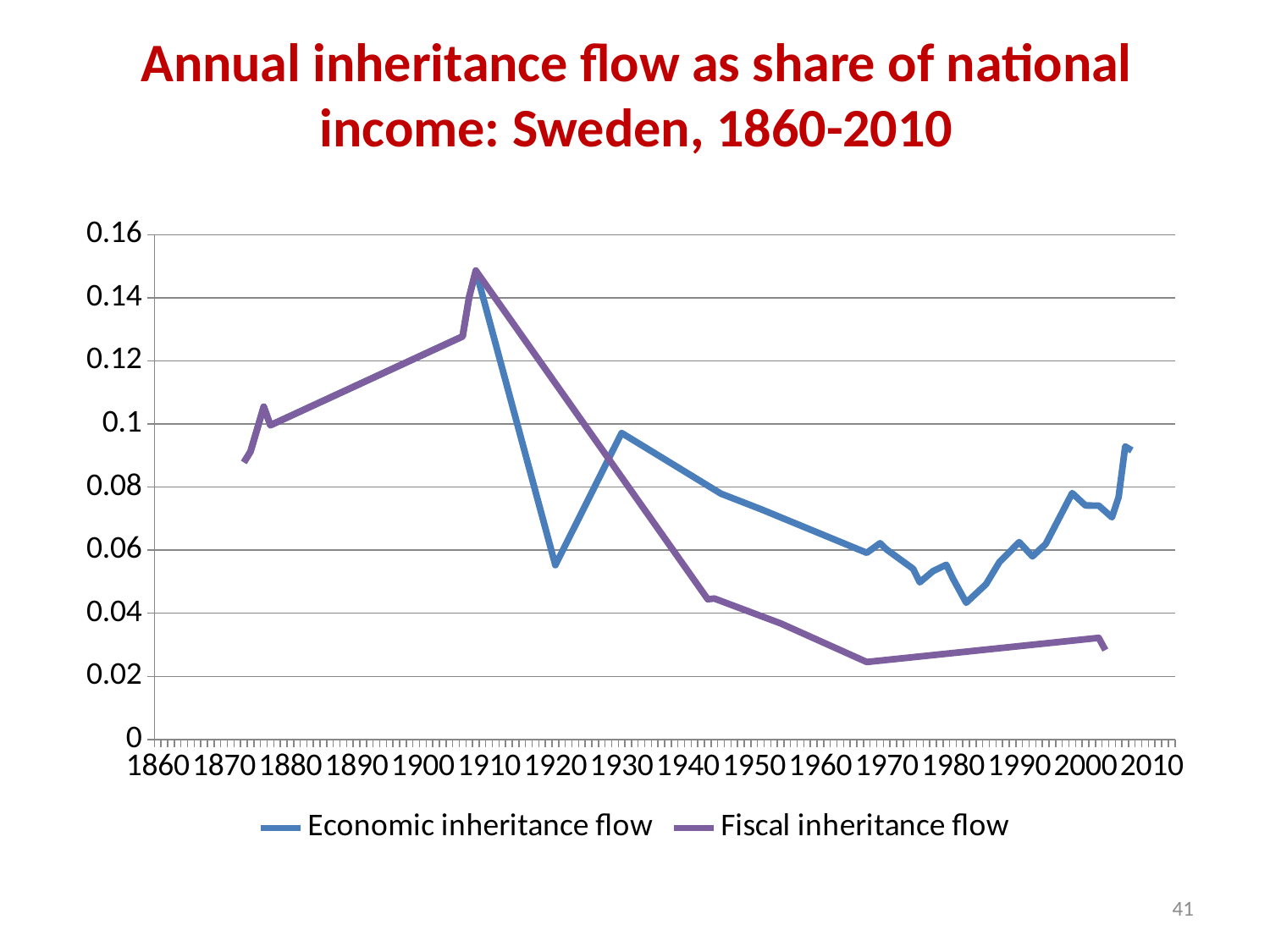
What kind of chart is shown on the slide? Line chart Is the peak value of the Fiscal inheritance flow around 1910 greater or less than 0.14? greater Around 1950, which series has the larger value, Economic inheritance flow or Fiscal inheritance flow? Economic inheritance flow Is the value of the Economic inheritance flow around 1930 greater or less than 0.08? greater Is the value of the Economic inheritance flow around 1920 greater or less than 0.08? less How many series does the legend list? 2 Around 2000, which series has the larger value, Economic inheritance flow or Fiscal inheritance flow? Economic inheritance flow Does the Fiscal inheritance flow rise or fall between 1910 and 1970? Fall What is the title of the chart? Annual inheritance flow as share of national income: Sweden, 1860-2010 Which series reaches the lowest value on the chart? Fiscal inheritance flow Which series is drawn in purple? Fiscal inheritance flow